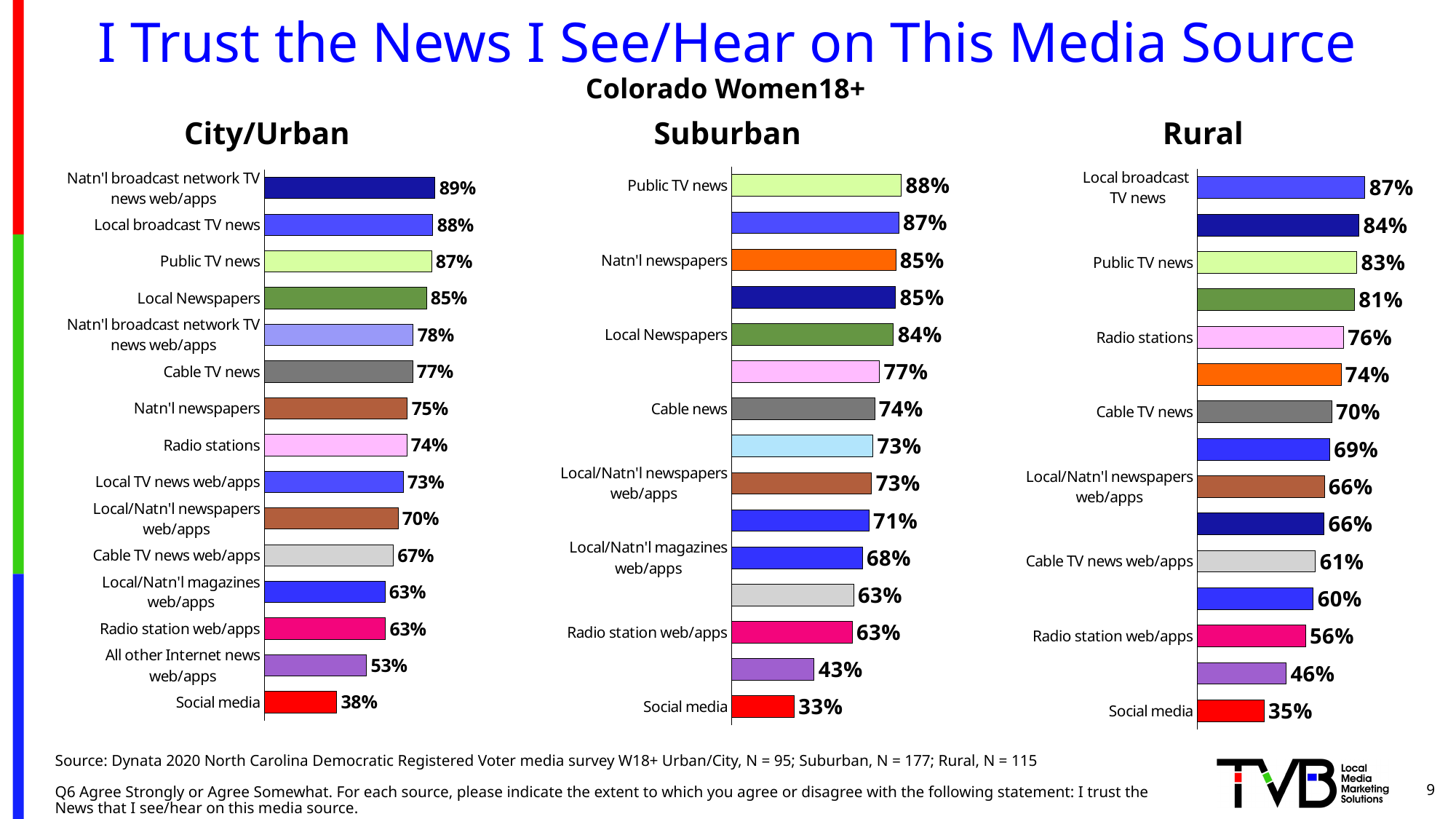
In the Suburban chart, what percentage is shown for Local Newspapers? 84% How many bars are plotted in the City/Urban chart? 15 In the Suburban chart, which is larger: the percentage for Cable news or for Radio station web/apps? Cable news In the Rural chart, what is the difference between the percentages for Local broadcast TV news and Cable TV news? 17% What is the subtitle shown beneath the main title of the slide? Colorado Women18+ In the City/Urban chart, what is the difference between the percentages for Public TV news and Social media? 49% In the Suburban chart, which media source has the highest percentage? Public TV news In the City/Urban chart, what percentage is shown for Local broadcast TV news? 88% In the City/Urban chart, which is larger: the percentage for Natn'l newspapers or for Cable TV news web/apps? Natn'l newspapers In the Rural chart, what percentage is shown for Radio stations? 76% What type of chart is used for the Suburban data? Bar chart In the Rural chart, which media source has the lowest percentage? Social media